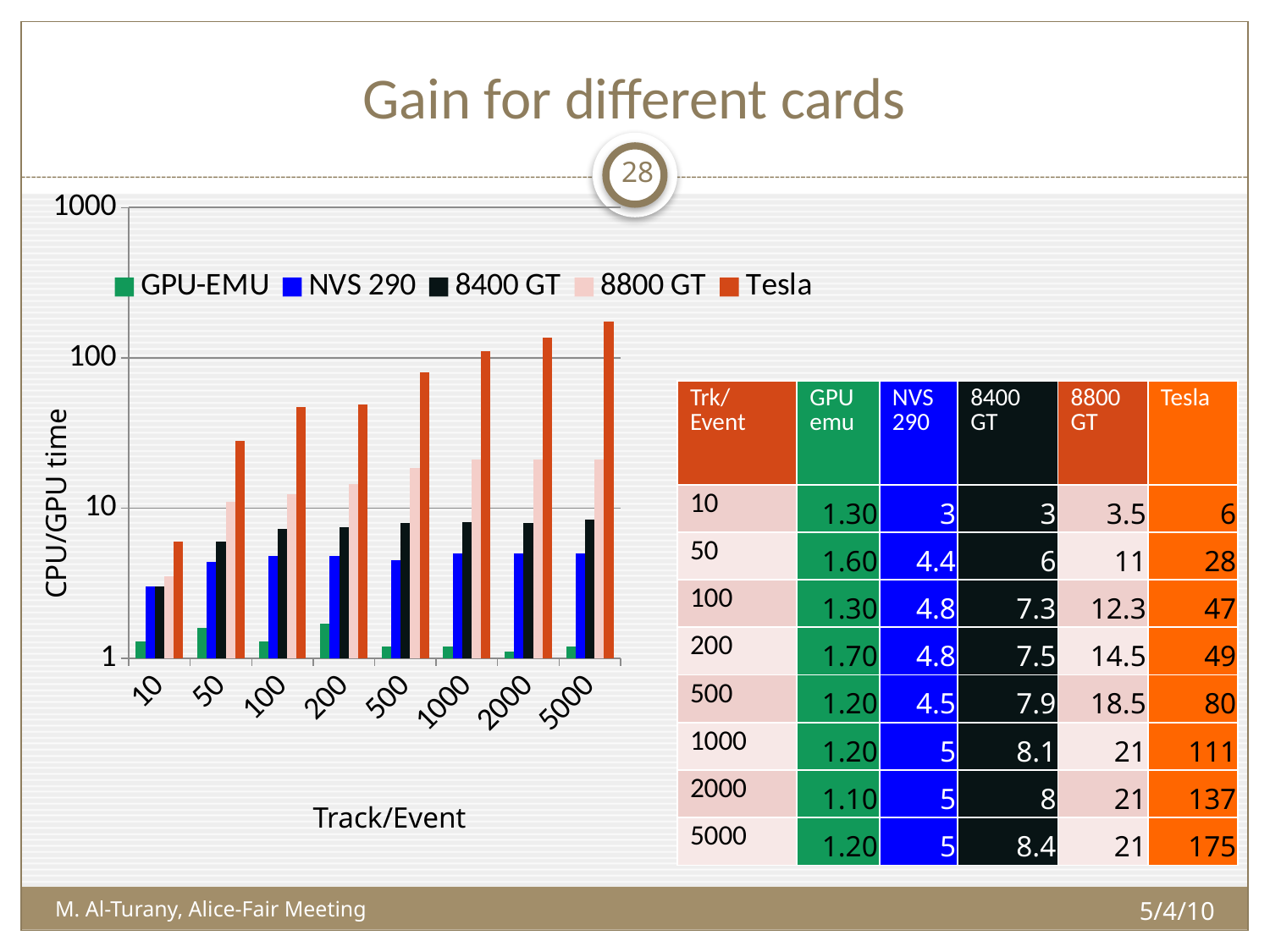
Which series has the lowest value at 1000 tracks per event? GPU-EMU How many series does the chart legend list? 5 What is the difference between the Tesla value and the 8800 GT value at 2000 tracks per event? 116 According to the table, what is the 8800 GT value at 500 tracks per event? 18.5 Which is larger at 50 tracks per event, the 8400 GT value or the NVS 290 value? 8400 GT According to the table, what is the Tesla value at 5000 tracks per event? 175 What is the label of the y axis of the chart? CPU/GPU time What kind of chart is shown on the slide? bar chart Does the Tesla series rise or fall as Track/Event increases along the x axis? rise Which card has the highest value at 5000 tracks per event? Tesla How many Track/Event categories are shown on the x axis of the chart? 8 Is the Tesla value at 1000 tracks per event greater or less than 100? greater